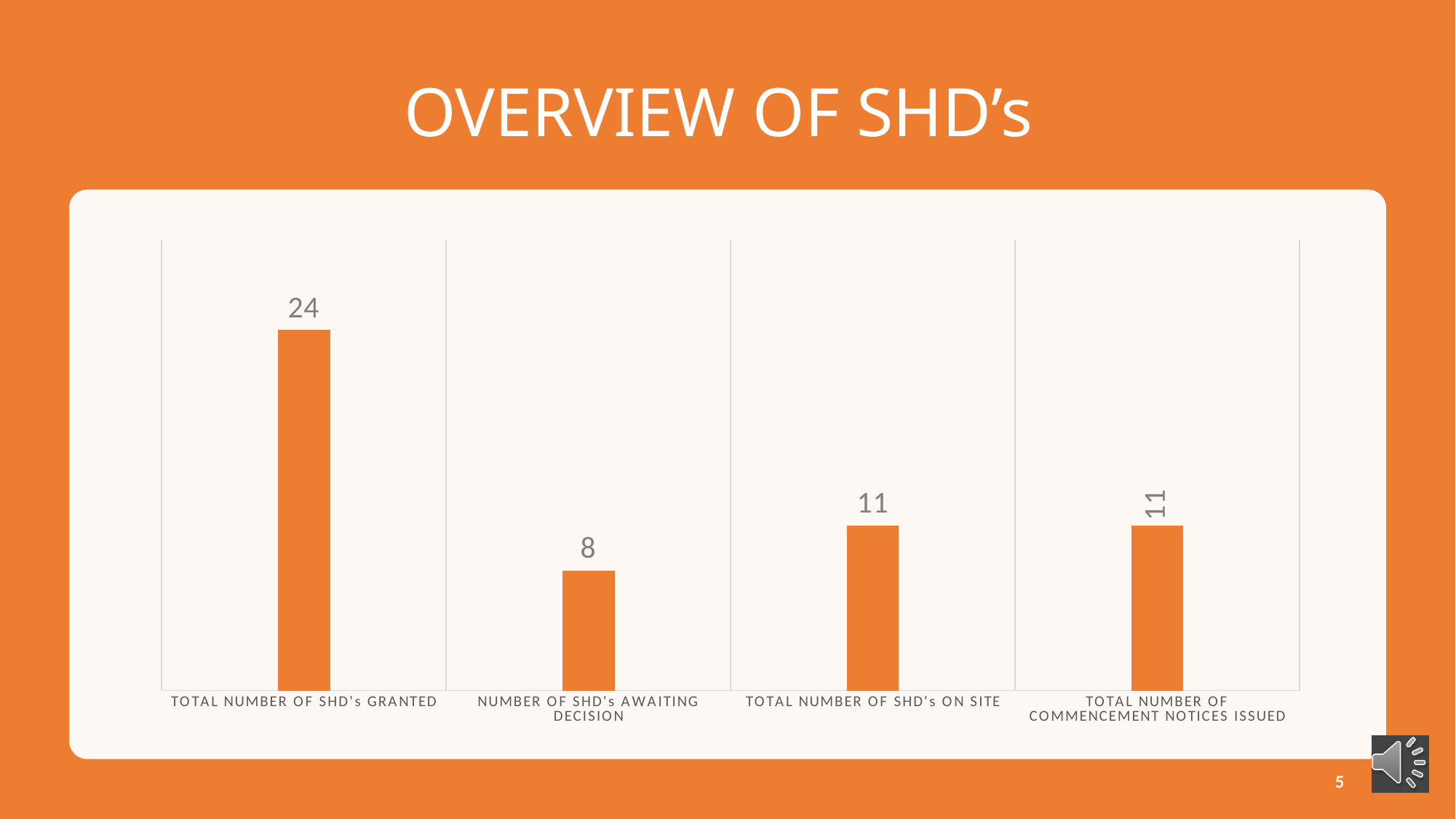
What is the value for NUMBER OF SHD's AWAITING DECISION? 8 What is the difference between TOTAL NUMBER OF SHD's GRANTED and NUMBER OF SHD's AWAITING DECISION? 16 What kind of chart is shown on the slide? Bar chart What is the value for TOTAL NUMBER OF SHD's GRANTED? 24 What is the difference between TOTAL NUMBER OF SHD's ON SITE and NUMBER OF SHD's AWAITING DECISION? 3 Which is larger, TOTAL NUMBER OF SHD's GRANTED or TOTAL NUMBER OF SHD's ON SITE? TOTAL NUMBER OF SHD's GRANTED What is the title of the slide containing the chart? OVERVIEW OF SHD’s What is the value for TOTAL NUMBER OF COMMENCEMENT NOTICES ISSUED? 11 Which category has the lowest value? NUMBER OF SHD's AWAITING DECISION Which category has the highest value? TOTAL NUMBER OF SHD's GRANTED How many categories are shown in the chart? 4 What is the value for TOTAL NUMBER OF SHD's ON SITE? 11